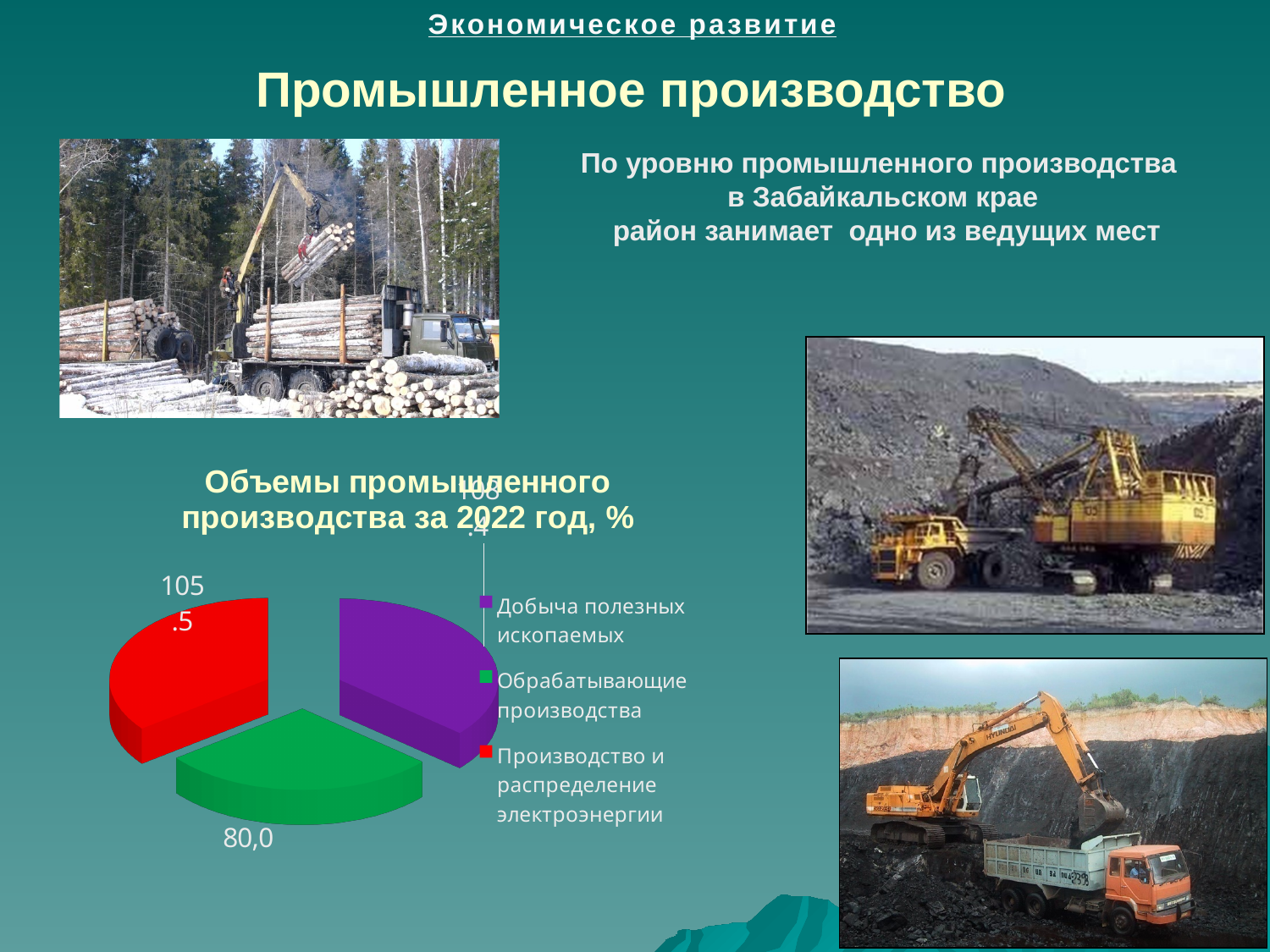
How many categories does the pie chart show? 3 What is the difference between the value for Производство и распределение электроэнергии and the value for Обрабатывающие производства? 25.5 What kind of chart is shown on the slide? pie chart Which is larger: the value for Производство и распределение электроэнергии or the value for Обрабатывающие производства? Производство и распределение электроэнергии Which category is represented by the green slice? Обрабатывающие производства What is the title of the chart on the slide? Объемы промышленного производства за 2022 год, % What is the value shown for Производство и распределение электроэнергии? 105.5 How many entries does the chart legend list? 3 Which category has the smallest slice in the pie chart? Обрабатывающие производства What is the value shown for Обрабатывающие производства? 80,0